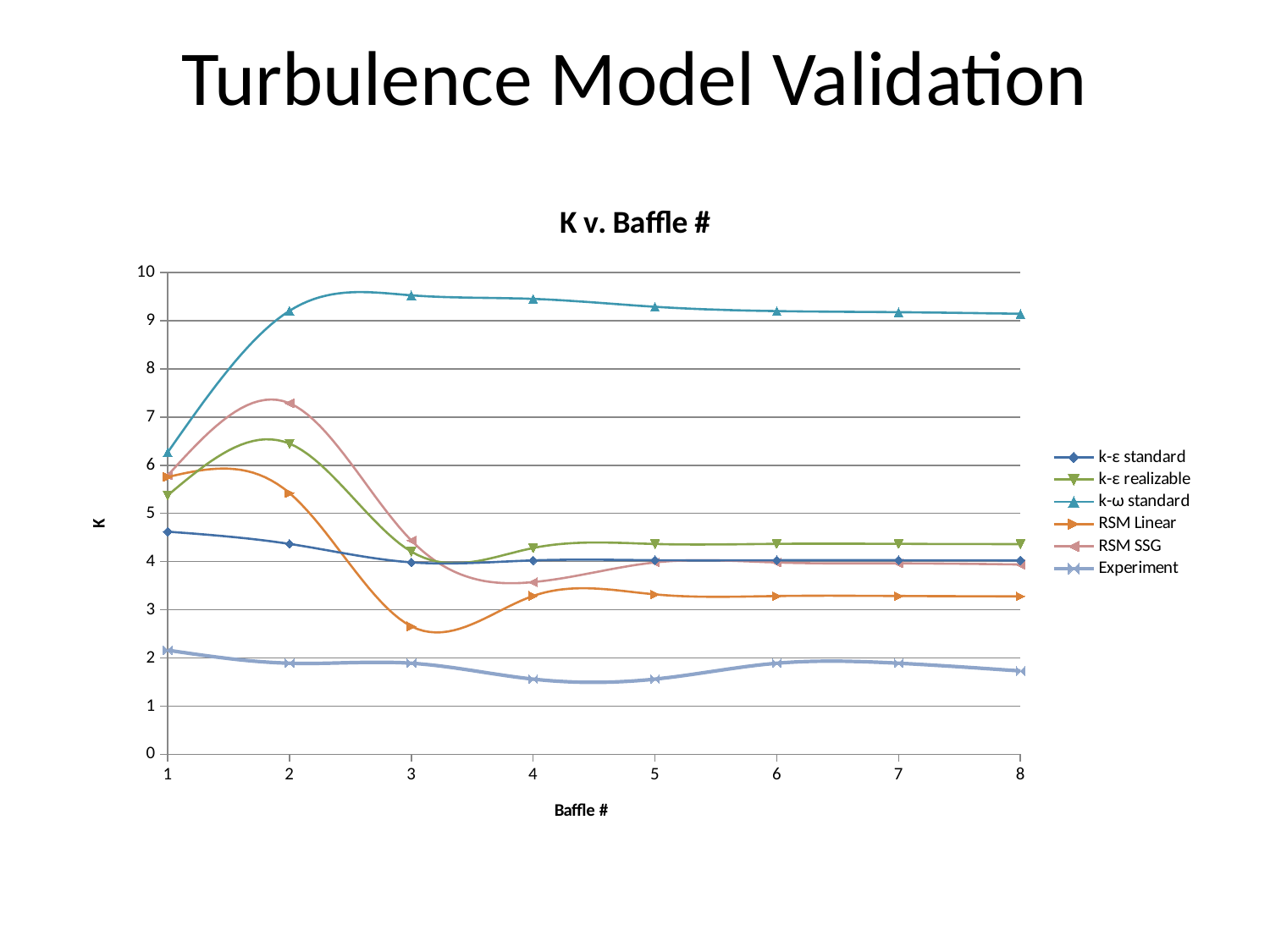
How many baffle numbers are plotted along the x axis? 8 What kind of chart is shown on the slide? line chart Is the value for Experiment at baffle 1 greater or less than 3? less Is the value for RSM Linear at baffle 3 greater or less than 3? less At baffle 2, which series has the larger K value, RSM SSG or k-ε realizable? RSM SSG How many series does the legend list? 6 What is the title of the chart? K v. Baffle # Does the RSM Linear series rise or fall from baffle 1 to baffle 3? fall What is the label of the x axis? Baffle # Which series has the lowest K value at baffle 5? Experiment Is the value for k-ω standard at baffle 3 greater or less than 9? greater Which series has the highest K value at baffle 3? k-ω standard